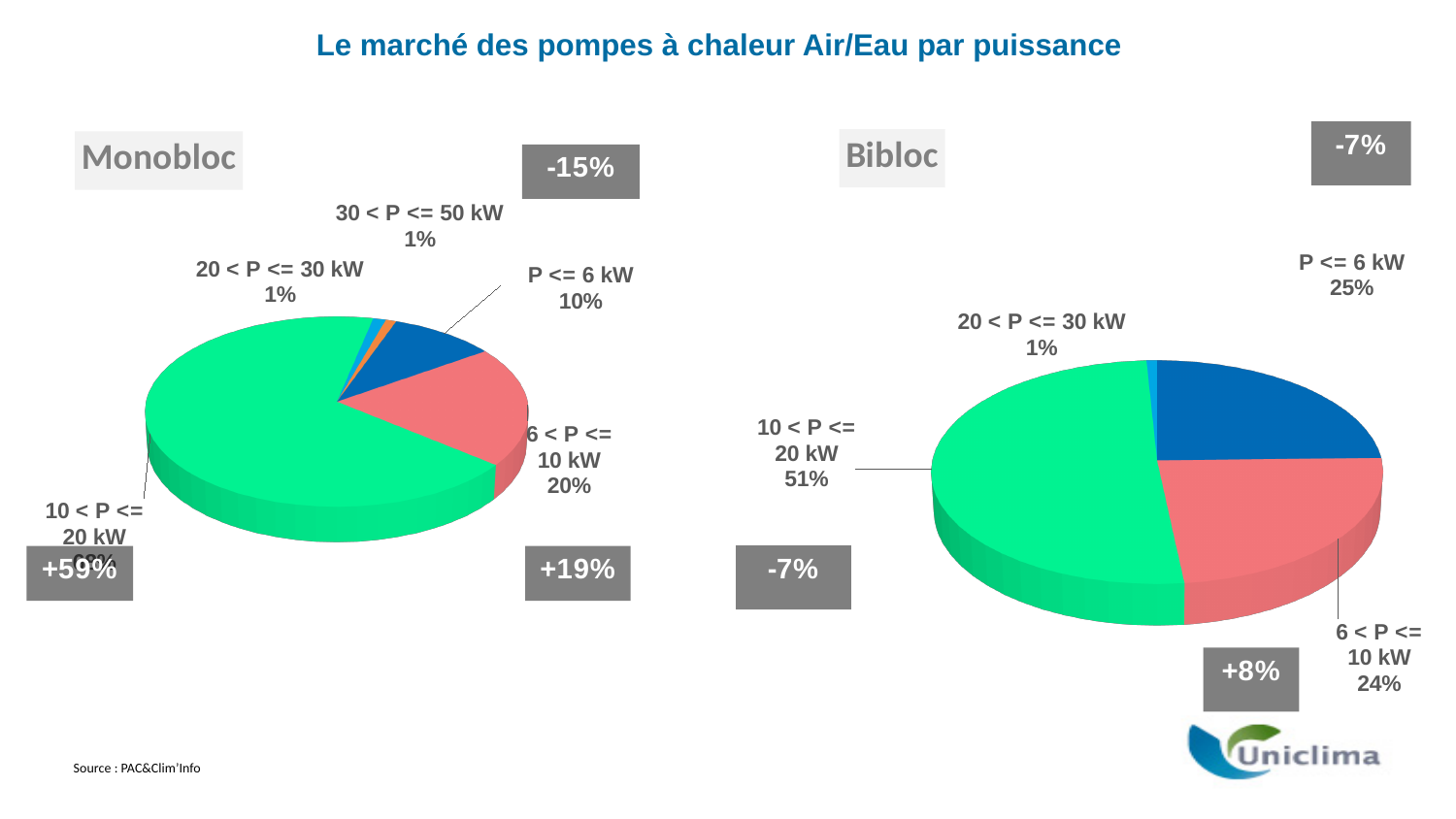
In the Monobloc pie chart, what share does the 30 < P <= 50 kW category have? 1% In the Bibloc pie chart, what share does the 10 < P <= 20 kW category have? 51% In the Monobloc pie chart, what is the difference between the shares of 6 < P <= 10 kW and P <= 6 kW? 10% In the Bibloc pie chart, what share does the P <= 6 kW category have? 25% In the Monobloc pie chart, what share does the P <= 6 kW category have? 10% In the Bibloc pie chart, which category has the largest share? 10 < P <= 20 kW In the Monobloc pie chart, what share does the 6 < P <= 10 kW category have? 20% How many categories are shown in the Bibloc pie chart? 4 In the Bibloc pie chart, what share does the 6 < P <= 10 kW category have? 24% In the Bibloc pie chart, which category has the smallest share? 20 < P <= 30 kW In the Bibloc pie chart, which is larger: the share of P <= 6 kW or the share of 20 < P <= 30 kW? P <= 6 kW In the Monobloc pie chart, which category has the largest share? 10 < P <= 20 kW